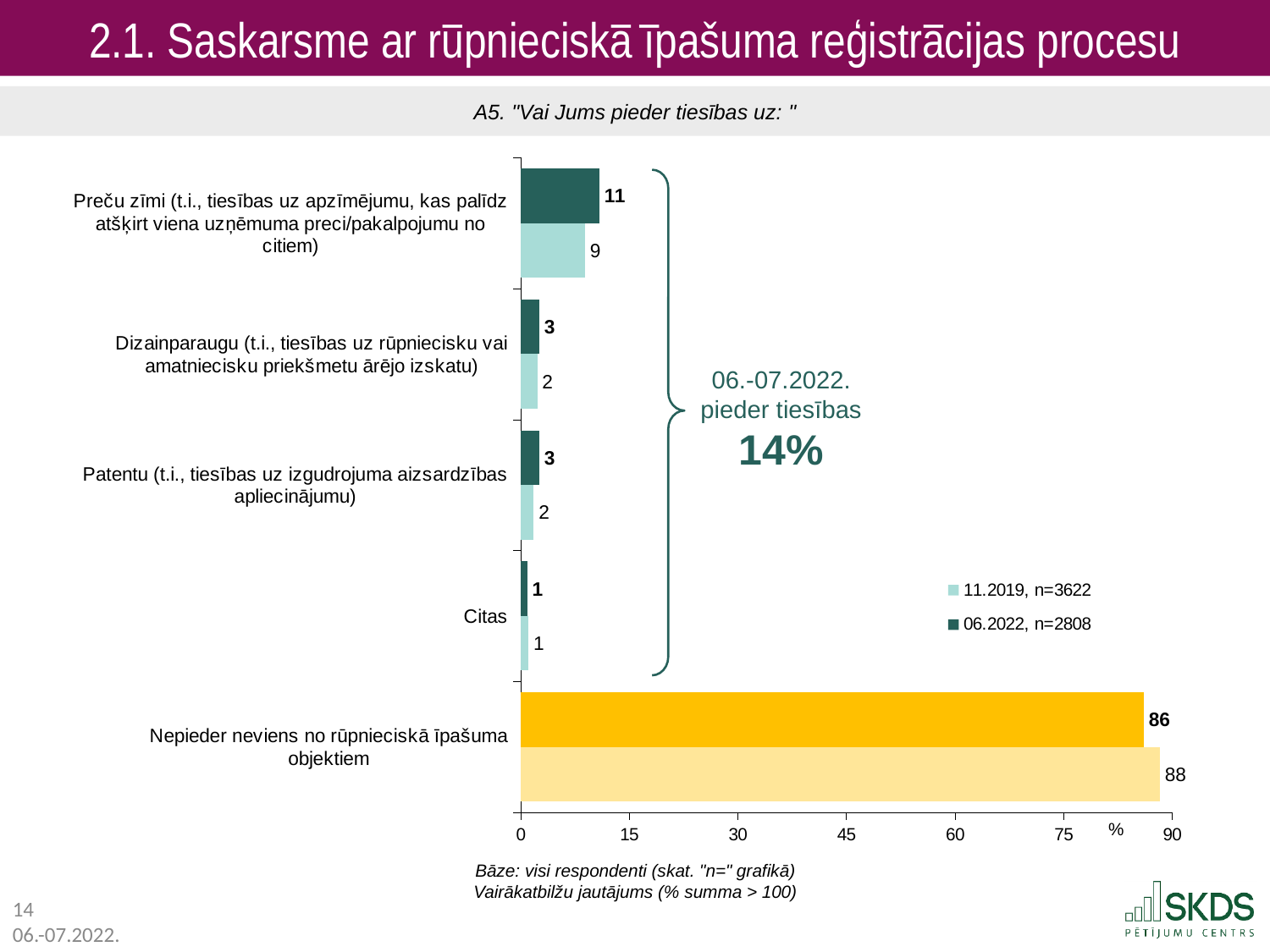
What is the value for "Preču zīmi" in the 11.2019, n=3622 series? 9 How many series does the legend list? 2 How many categories are shown on the chart? 5 What is the difference between the 06.2022 and 11.2019 values for "Preču zīmi"? 2 What is the value for "Citas" in the 06.2022, n=2808 series? 1 What is the value for "Nepieder neviens no rūpnieciskā īpašuma objektiem" in the 06.2022, n=2808 series? 86 Which category has the highest value in the 06.2022, n=2808 series? Nepieder neviens no rūpnieciskā īpašuma objektiem What is the value for "Nepieder neviens no rūpnieciskā īpašuma objektiem" in the 11.2019, n=3622 series? 88 Which category has the lowest value in the 11.2019, n=3622 series? Citas What kind of chart is shown on the slide? Bar chart What is the value for "Preču zīmi" in the 06.2022, n=2808 series? 11 Which is larger for "Nepieder neviens no rūpnieciskā īpašuma objektiem": the 11.2019 value or the 06.2022 value? 11.2019